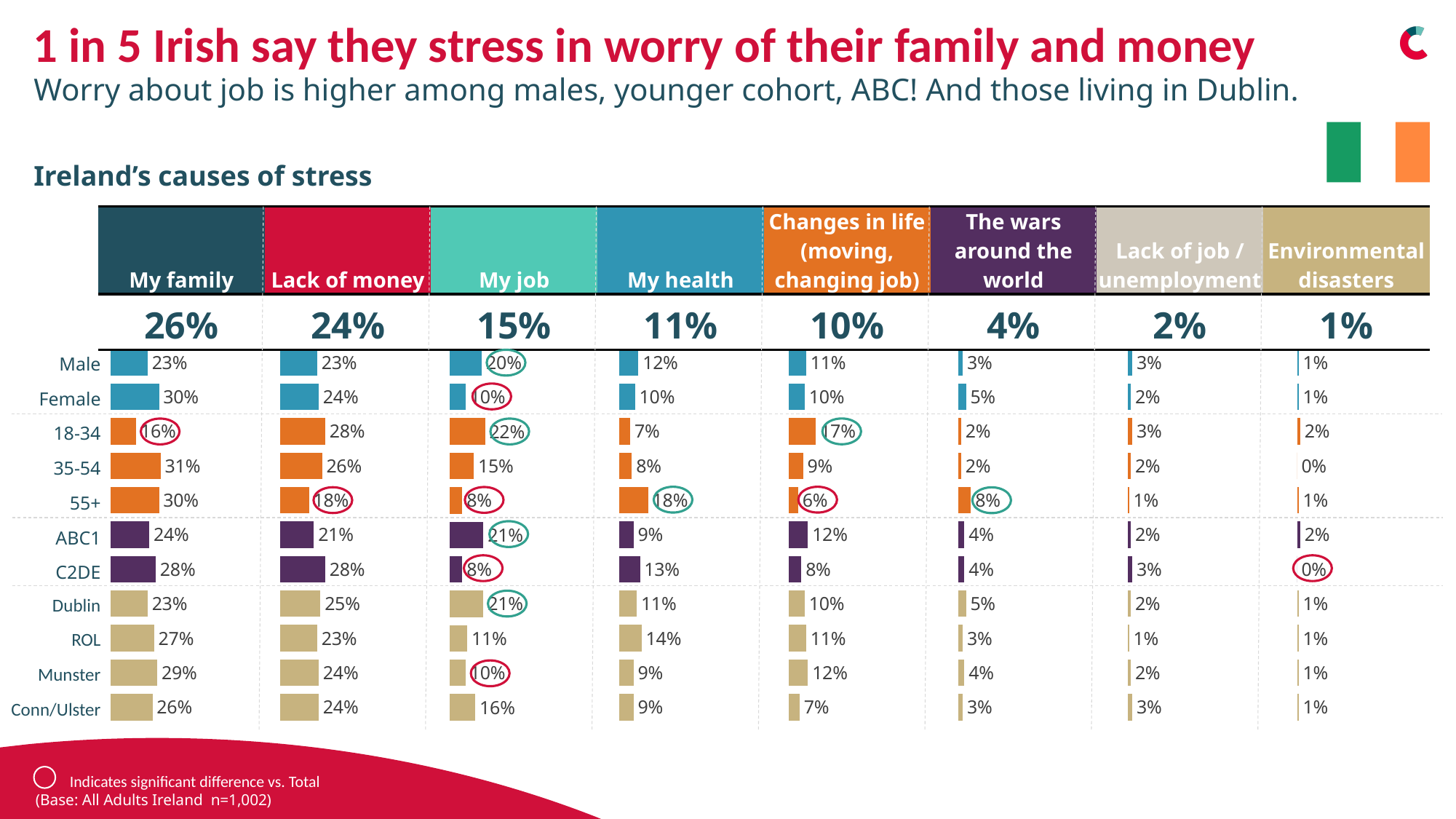
Which cause of stress has the highest overall percentage? My family What percentage of Dublin respondents cite 'My job' as a cause of stress? 21% How many causes of stress are shown across the top of the chart? 8 What is the difference in percentage points between males and females for 'My job'? 10 percentage points Which cause of stress has the lowest overall percentage? Environmental disasters What percentage of females say 'My family' is a cause of stress? 30% For 'My job', which group has the larger value: 18-34 or 55+? 18-34 What percentage of the 18-34 group cite 'Lack of money' as a cause of stress? 28% What kind of chart is used to show the breakdown by group? Bar chart What is the overall percentage shown for 'My family' as a cause of stress? 26% According to the footnote, what does a circle around a value indicate? Significant difference vs. Total What percentage of the 55+ group cite 'My health' as a cause of stress? 18%